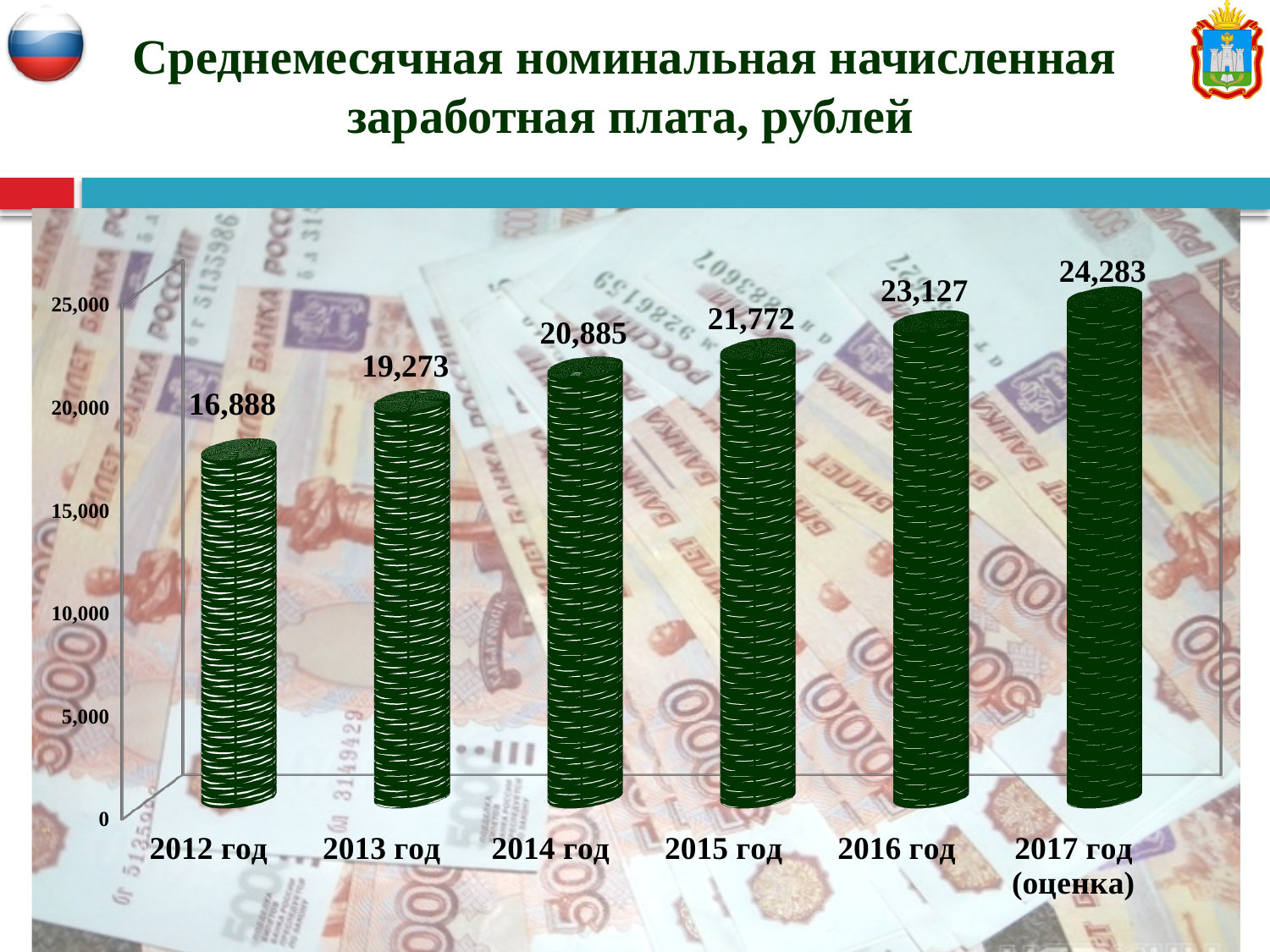
How many years are shown on the chart? 6 Which is larger, the value for 2015 год or the value for 2014 год? 2015 год What is the value for 2012 год? 16,888 Which year has the lowest value? 2012 год What is the value for 2017 год (оценка)? 24,283 Which year has the highest value? 2017 год (оценка) What is the value for 2014 год? 20,885 What is the difference between the values for 2016 год and 2015 год? 1,355 What is the difference between the values for 2013 год and 2012 год? 2,385 Do the values rise or fall from 2012 год to 2017 год? rise What kind of chart is shown on the slide? bar chart Is the value for 2016 год greater or less than 20,000? greater